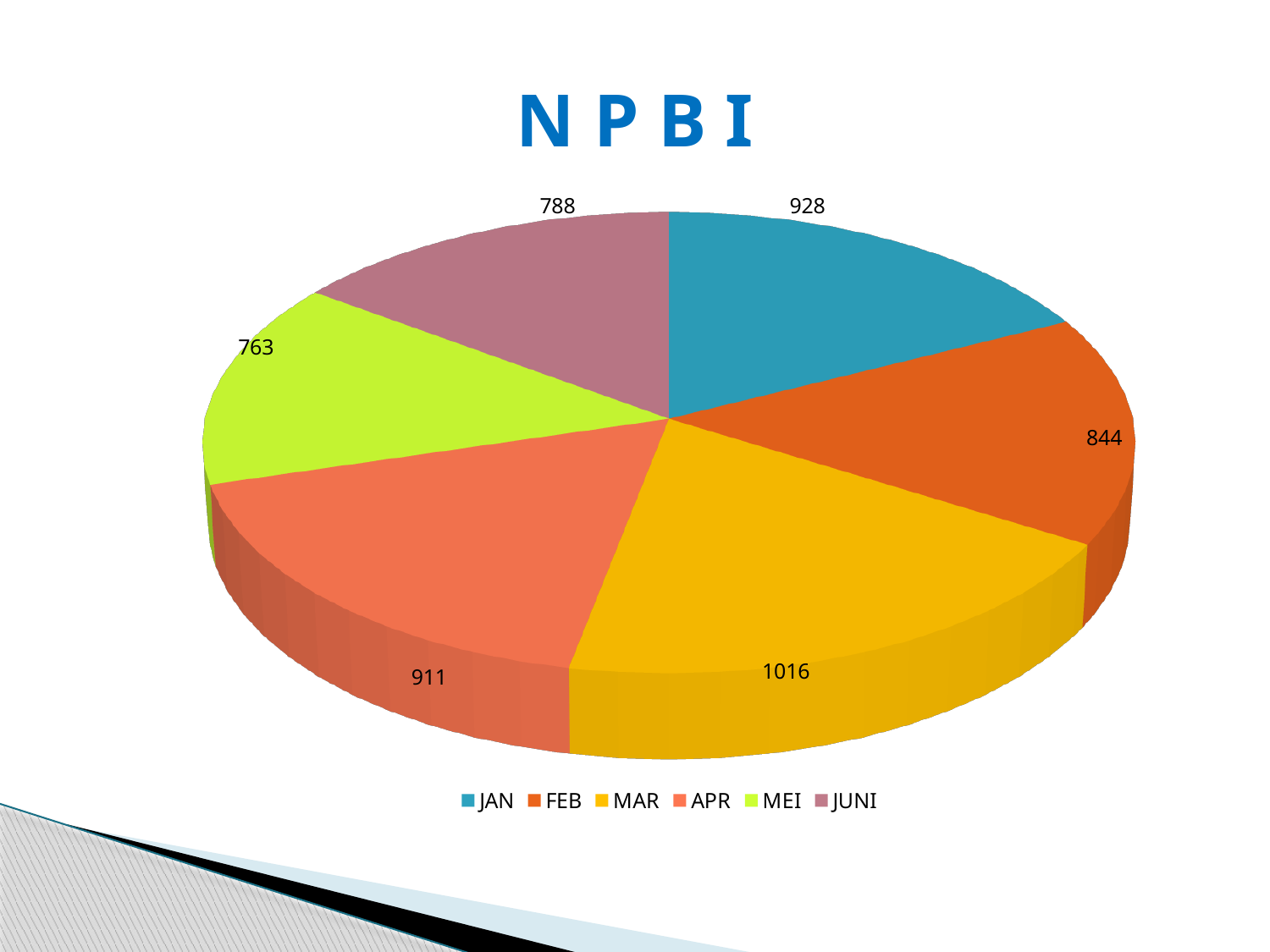
What is the value for JUNI in the pie chart? 788 Which month has the smallest slice in the pie chart? MEI What is the difference between the values for MAR and MEI? 253 Which month is shown in yellow-green in the pie chart? MEI How many slices does the pie chart have? 6 Which month has the largest slice in the pie chart? MAR What is the difference between the values for JAN and FEB? 84 What is the value for MAR in the pie chart? 1016 What is the title of the chart? N P B I What is the value for MEI in the pie chart? 763 Which is larger, the value for APR or the value for JUNI? APR What kind of chart is shown on the slide? Pie chart